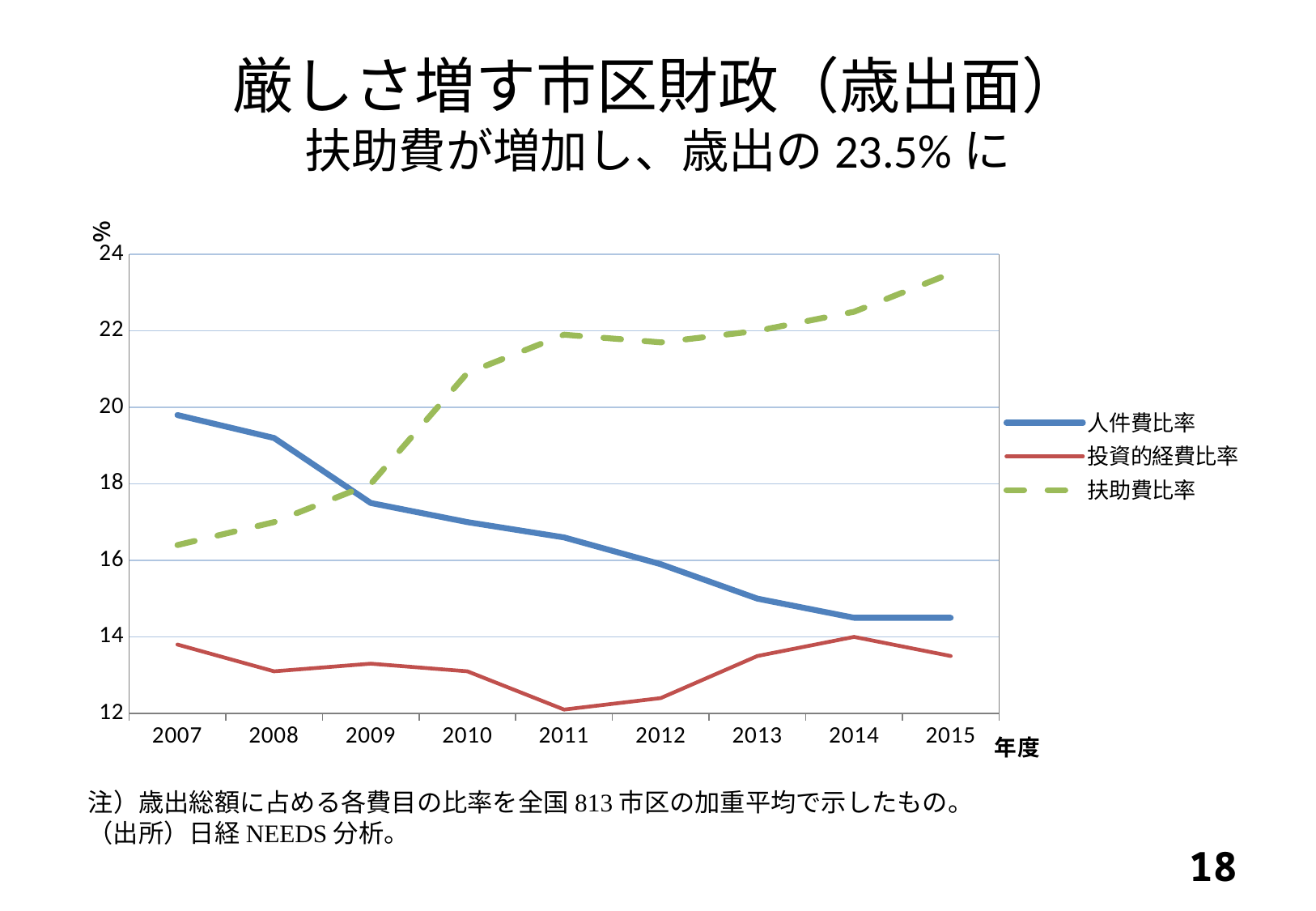
What kind of chart is shown on the slide? line chart How many years are plotted along the x axis? 9 Is the value for 投資的経費比率 in 2011 greater or less than 14? less Which series has the highest value in 2015? 扶助費比率 Is the value for 人件費比率 in 2007 greater or less than 20? less In 2007, which is larger: 人件費比率 or 扶助費比率? 人件費比率 Is the value for 扶助費比率 in 2015 greater or less than 22? greater Does 扶助費比率 rise or fall from 2007 to 2015? rise Does 人件費比率 rise or fall from 2007 to 2015? fall Which series is drawn with a dashed line? 扶助費比率 Which series has the lowest value in 2007? 投資的経費比率 How many series does the legend list? 3